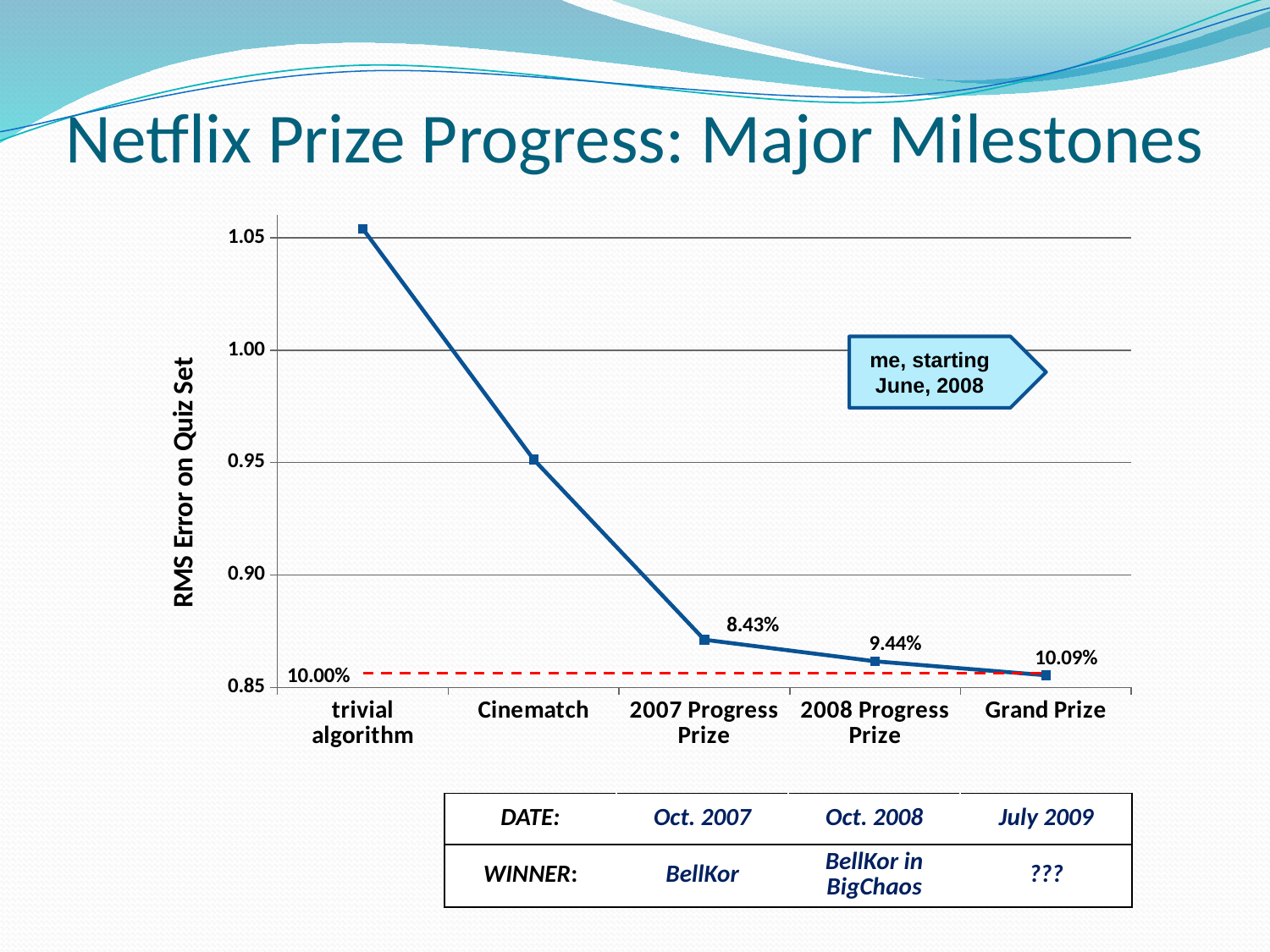
What kind of chart is shown on the slide? line chart Which has a larger RMS error, Cinematch or the 2008 Progress Prize? Cinematch What percentage label is printed next to the 2008 Progress Prize point? 9.44% What is the label on the y axis of the chart? RMS Error on Quiz Set Do the RMS error values rise or fall from the trivial algorithm to the Grand Prize? fall Which milestone has the highest RMS error on the quiz set? trivial algorithm Is the RMS error for the 2007 Progress Prize greater or less than 0.90? less How many milestones are plotted along the x axis? 5 Which milestone has the lowest RMS error on the quiz set? Grand Prize Is the RMS error for the trivial algorithm greater or less than 1.00? greater What percentage label is printed next to the 2007 Progress Prize point? 8.43% What percentage label is printed next to the Grand Prize point? 10.09%